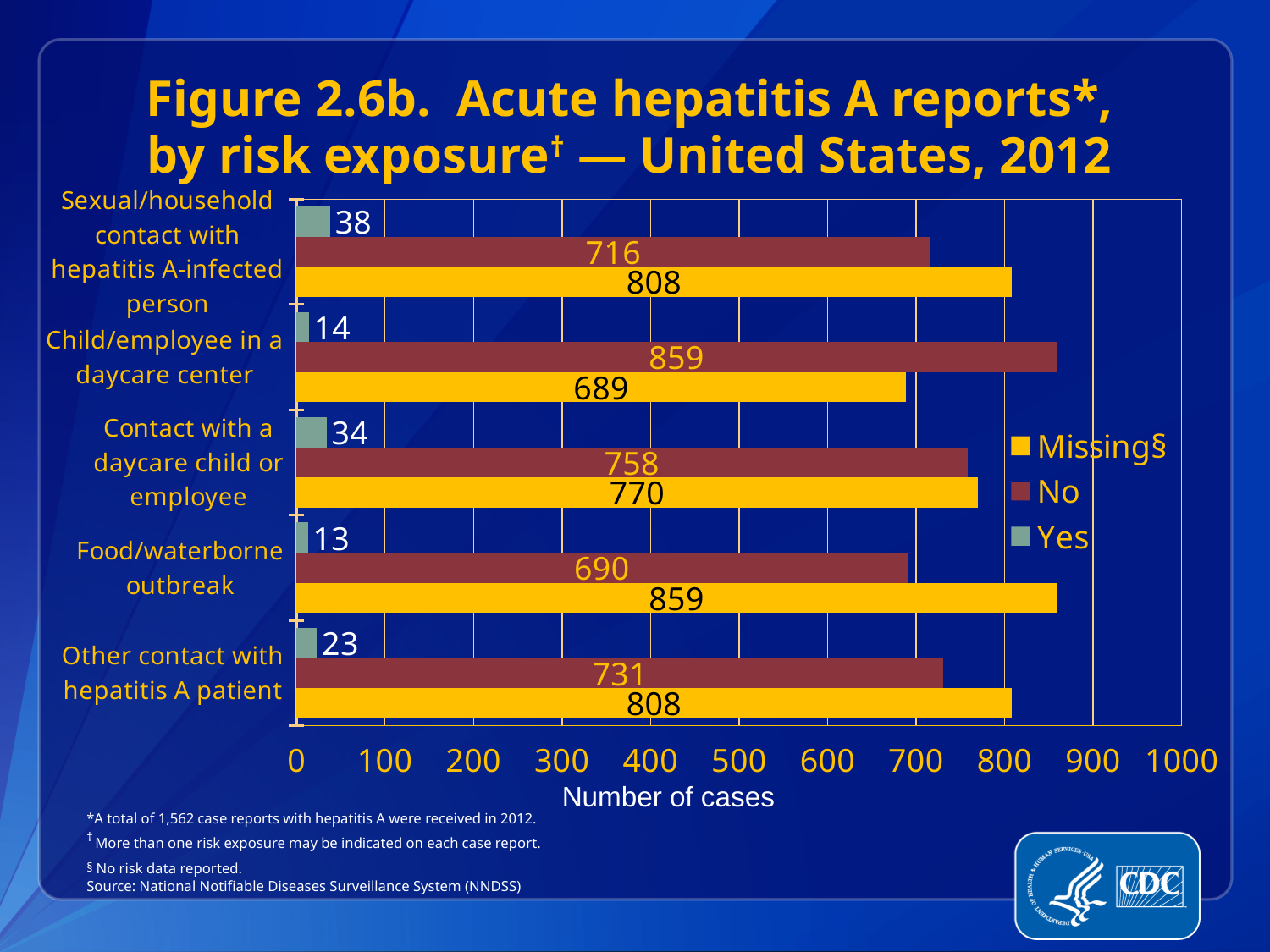
How many risk exposure categories are shown on the chart? 5 For Contact with a daycare child or employee, which is larger: the "Missing" value or the "No" value? Missing What kind of chart is shown on the slide? Bar chart What is the number of cases in the "Missing" series for Food/waterborne outbreak? 859 What is the label of the x axis? Number of cases What is the total of the "Yes", "No" and "Missing" values for Child/employee in a daycare center? 1,562 Which risk exposure category has the lowest value in the "Yes" series? Food/waterborne outbreak How many series does the legend list? 3 What is the difference between the "No" and "Yes" values for Other contact with hepatitis A patient? 708 What is the number of cases in the "Yes" series for Sexual/household contact with hepatitis A-infected person? 38 Which risk exposure category has the highest value in the "Yes" series? Sexual/household contact with hepatitis A-infected person What is the number of cases in the "No" series for Child/employee in a daycare center? 859